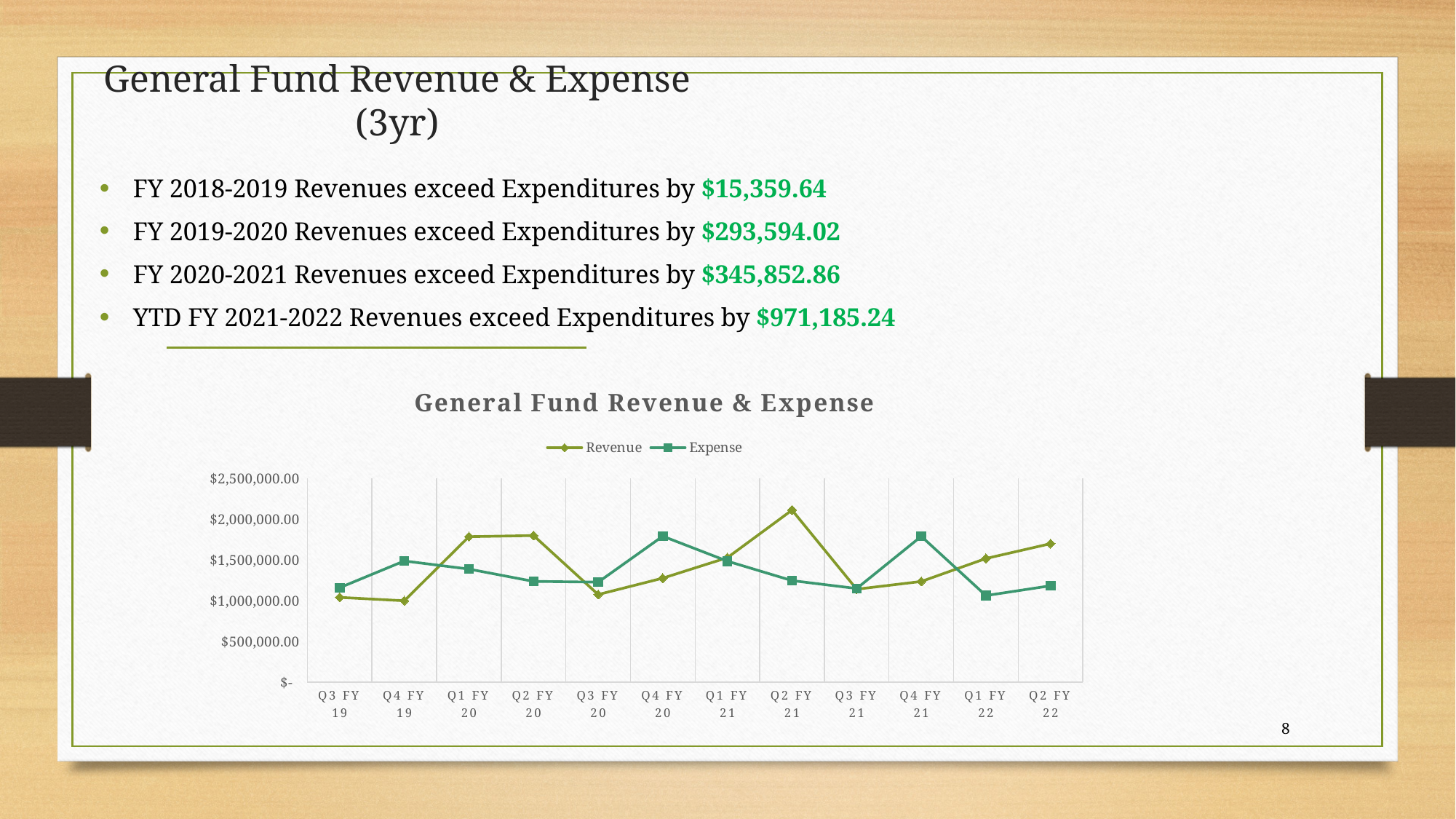
How many series does the chart legend list? 2 Is the Expense value for Q4 FY 20 greater or less than $1,500,000.00? greater In which quarter is Expense lowest? Q1 FY 22 Is the Revenue value for Q2 FY 21 greater or less than $2,000,000.00? greater What is the title of the chart? General Fund Revenue & Expense What type of chart is shown on the slide? line chart In which quarter is Revenue highest? Q2 FY 21 Is the Revenue value for Q4 FY 19 greater or less than $1,500,000.00? less In Q1 FY 20, which is larger: Revenue or Expense? Revenue How many quarters are plotted along the x axis of the chart? 12 In Q4 FY 21, which is larger: Revenue or Expense? Expense Does Revenue rise or fall from Q3 FY 21 to Q2 FY 22? rise